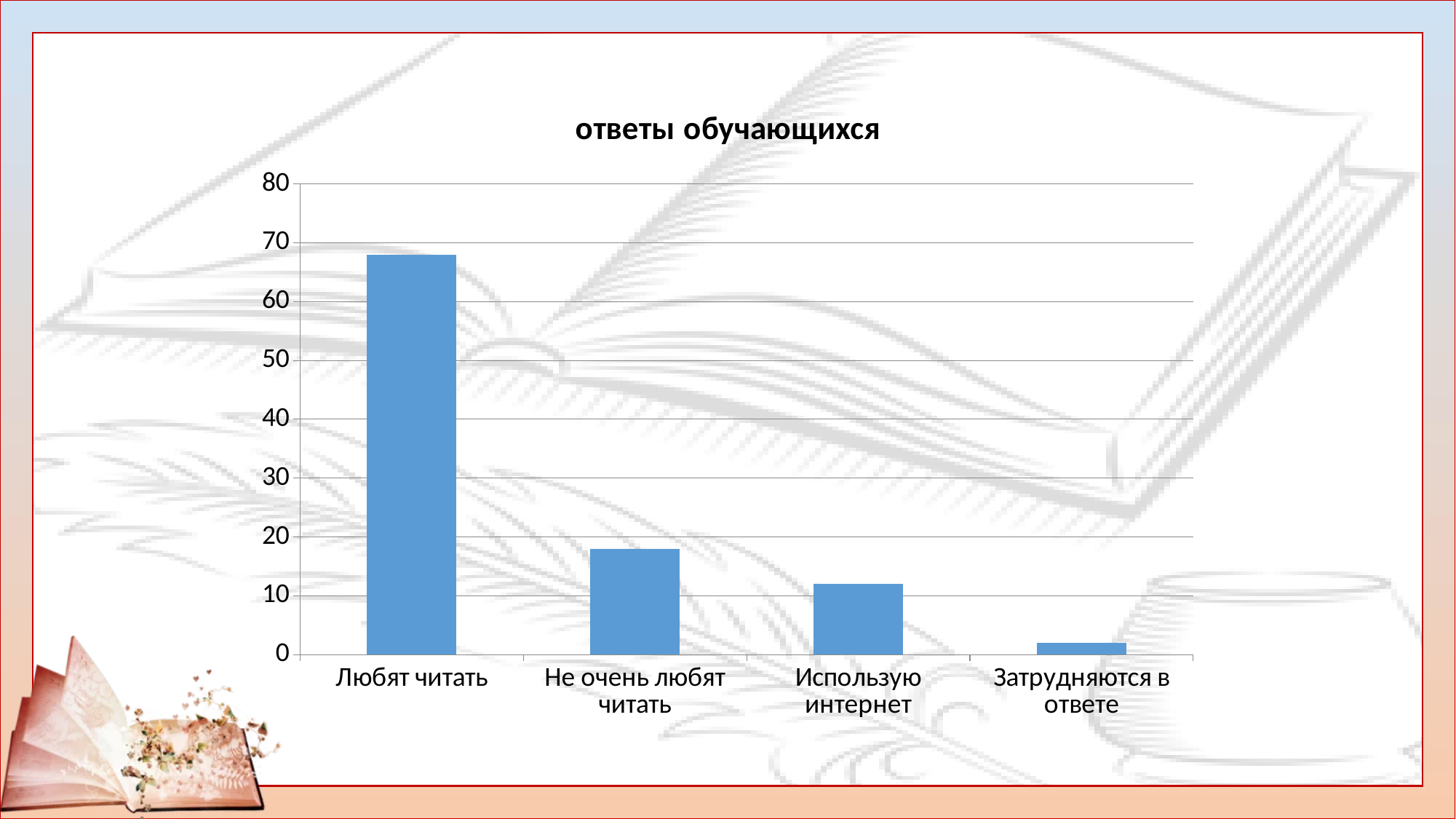
What is the title of the chart? ответы обучающихся Which is larger: the value for Используют интернет or the value for Затрудняются в ответе? Используют интернет Which category has the lowest value? Затрудняются в ответе What kind of chart is shown on the slide? bar chart Is the value for Не очень любят читать greater or less than 20? less Which is larger: the value for Не очень любят читать or the value for Используют интернет? Не очень любят читать How many categories are shown on the x axis of the chart? 4 Is the value for Любят читать greater or less than 60? greater Is the value for Затрудняются в ответе greater or less than 10? less Which category has the highest value? Любят читать Do the values rise or fall from left to right along the x axis? fall